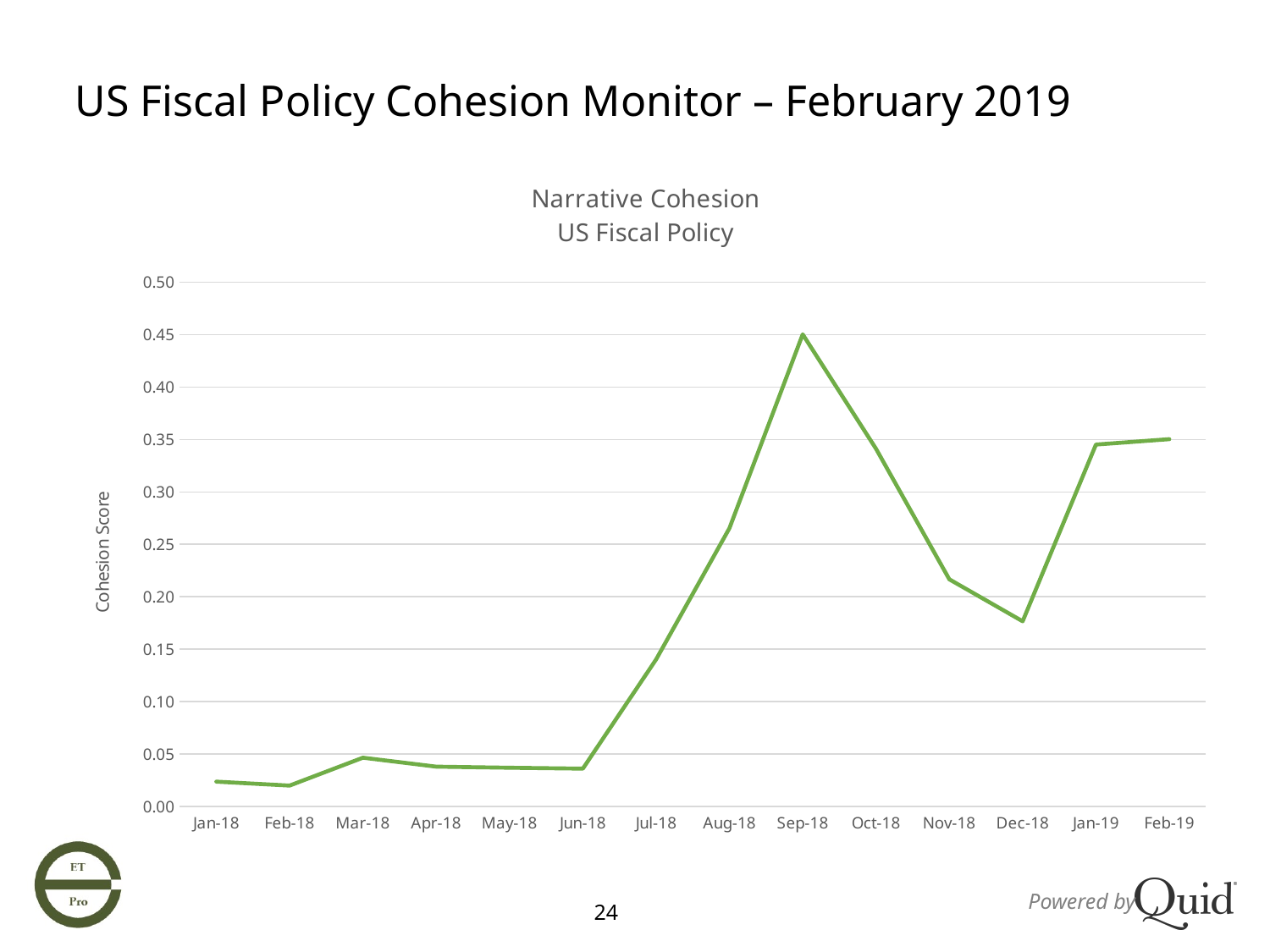
Which is larger, the value for Sep-18 or the value for Jan-19? Sep-18 Does the cohesion score rise or fall from Jun-18 to Sep-18? rise Is the value for Dec-18 greater or less than 0.20? less Is the value for Jan-18 greater or less than 0.05? less What kind of chart is shown on the slide? line chart What is the cohesion score for Sep-18? 0.45 Is the value for Aug-18 greater or less than 0.25? greater What is the label on the y axis? Cohesion Score How many months are plotted on the x axis? 14 Which month has the highest cohesion score? Sep-18